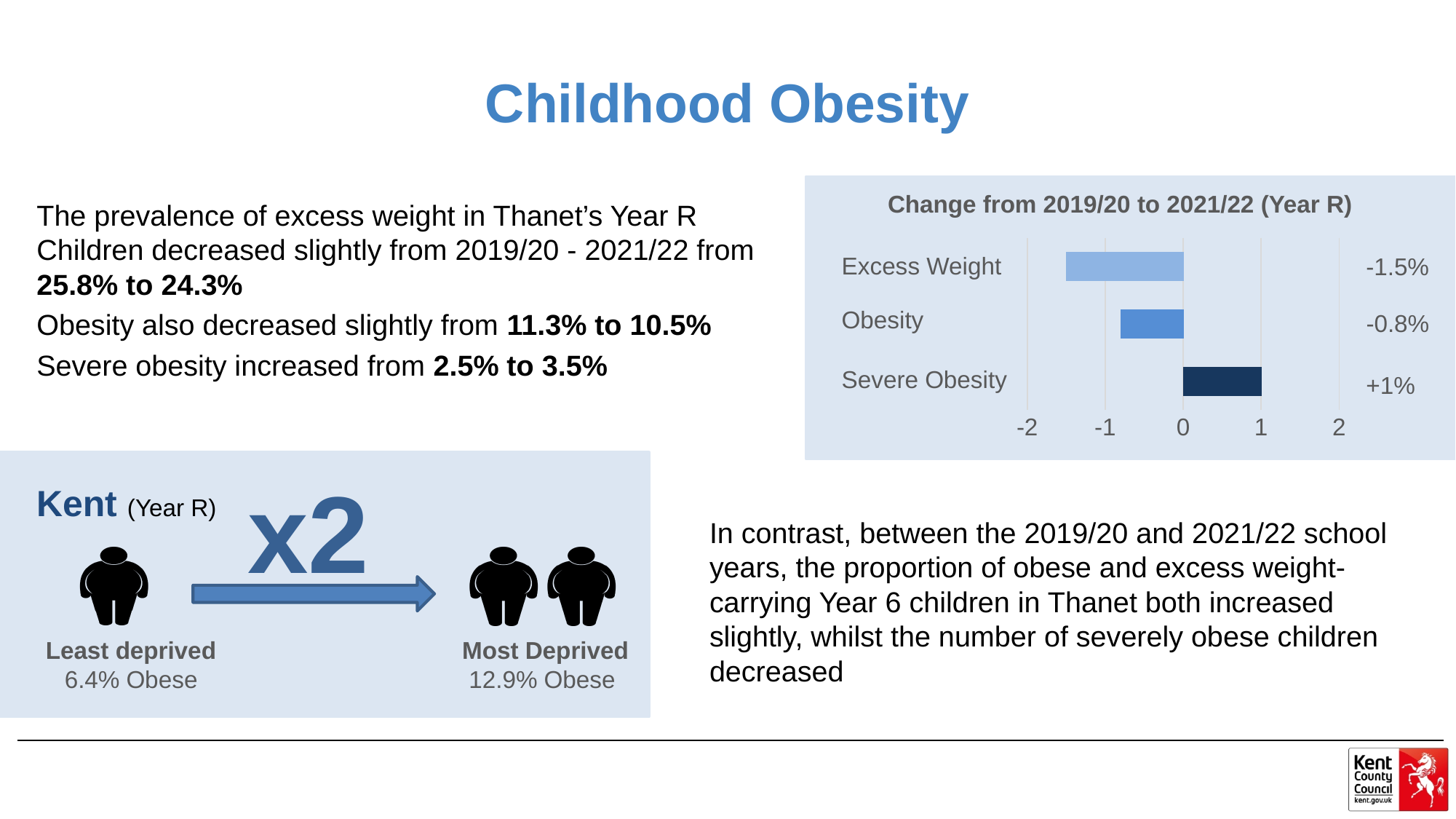
Which has a larger decrease in the chart, Excess Weight or Obesity? Excess Weight What is the change shown for Excess Weight in the chart? -1.5% What is the change shown for Severe Obesity in the chart? +1% What is the change shown for Obesity in the chart? -0.8% What is the title of the chart on the slide? Change from 2019/20 to 2021/22 (Year R) Which category in the chart is the only one with a positive change? Severe Obesity What kind of chart is shown on the slide? bar chart Is the value for Obesity in the chart greater or less than -1? greater How many categories does the chart show? 3 Is the value for Excess Weight in the chart greater or less than -1? less What is the difference between the change for Excess Weight and the change for Obesity in the chart? 0.7% Which category in the chart has the largest decrease? Excess Weight